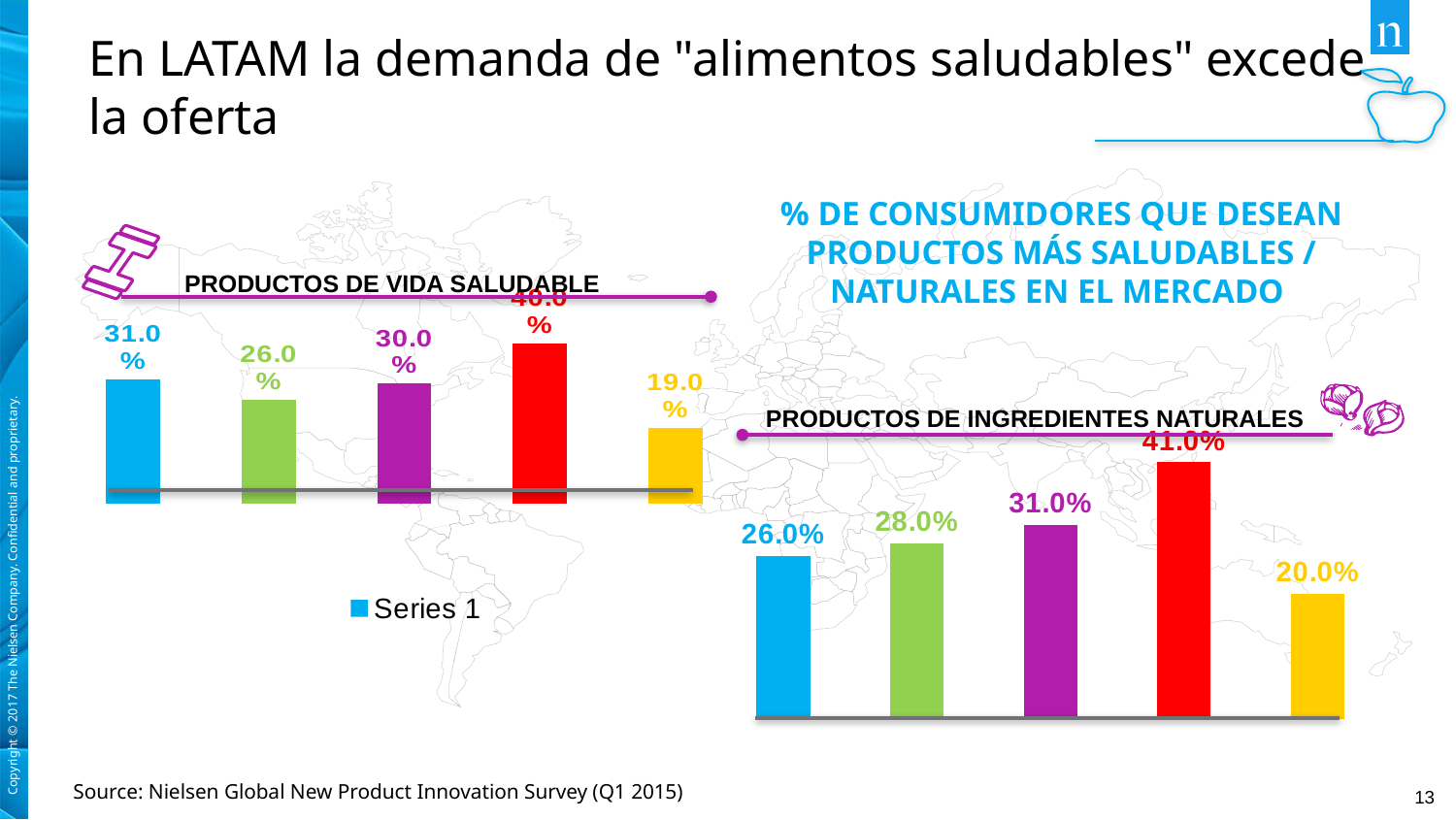
In the 'PRODUCTOS DE VIDA SALUDABLE' chart, what is the value of the fourth (red) bar? 40.0% In the 'PRODUCTOS DE INGREDIENTES NATURALES' chart, what is the value of the third (purple) bar? 31.0% Which is larger: the green bar in the 'PRODUCTOS DE VIDA SALUDABLE' chart or the green bar in the 'PRODUCTOS DE INGREDIENTES NATURALES' chart? The green bar in 'PRODUCTOS DE INGREDIENTES NATURALES' (28.0%) In the 'PRODUCTOS DE VIDA SALUDABLE' chart, what is the difference between the red bar (40.0%) and the yellow bar (19.0%)? 21.0% In the 'PRODUCTOS DE INGREDIENTES NATURALES' chart, which bar has the lowest value? The last (yellow) bar, 20.0% In the 'PRODUCTOS DE INGREDIENTES NATURALES' chart, what is the value of the last (yellow) bar? 20.0% How many bars are in the 'PRODUCTOS DE INGREDIENTES NATURALES' chart? 5 In the 'PRODUCTOS DE VIDA SALUDABLE' chart, what is the value of the first (blue) bar? 31.0% What type of chart is used for 'PRODUCTOS DE VIDA SALUDABLE'? Bar chart In the 'PRODUCTOS DE INGREDIENTES NATURALES' chart, what is the difference between the red bar (41.0%) and the blue bar (26.0%)? 15.0% What legend entry is shown below the 'PRODUCTOS DE VIDA SALUDABLE' chart? Series 1 In the 'PRODUCTOS DE VIDA SALUDABLE' chart, which bar has the highest value? The fourth (red) bar, 40.0%